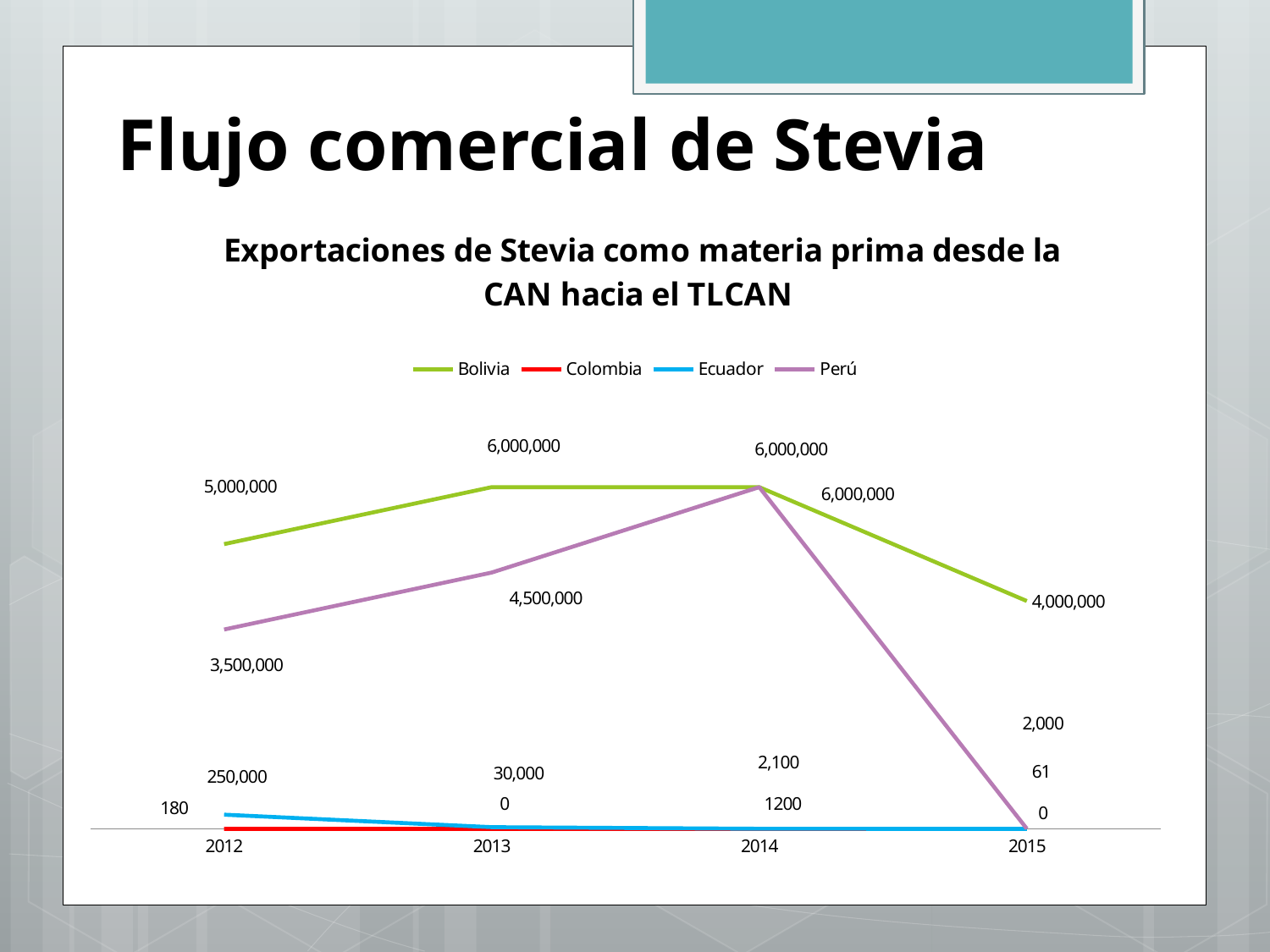
What is the value for Bolivia in 2015? 4,000,000 What is the value for Perú in 2012? 3,500,000 Does the value for Perú rise or fall from 2014 to 2015? fall What is the difference between Bolivia's value in 2013 and its value in 2015? 2,000,000 What is the value for Bolivia in 2012? 5,000,000 In which year does Perú reach its highest value? 2014 What is the value for Perú in 2013? 4,500,000 In 2013, which is larger, the value for Bolivia or the value for Perú? Bolivia How many series does the legend list? 4 What is the value for Ecuador in 2012? 250,000 How many years are shown on the x axis? 4 What kind of chart is shown on the slide? line chart